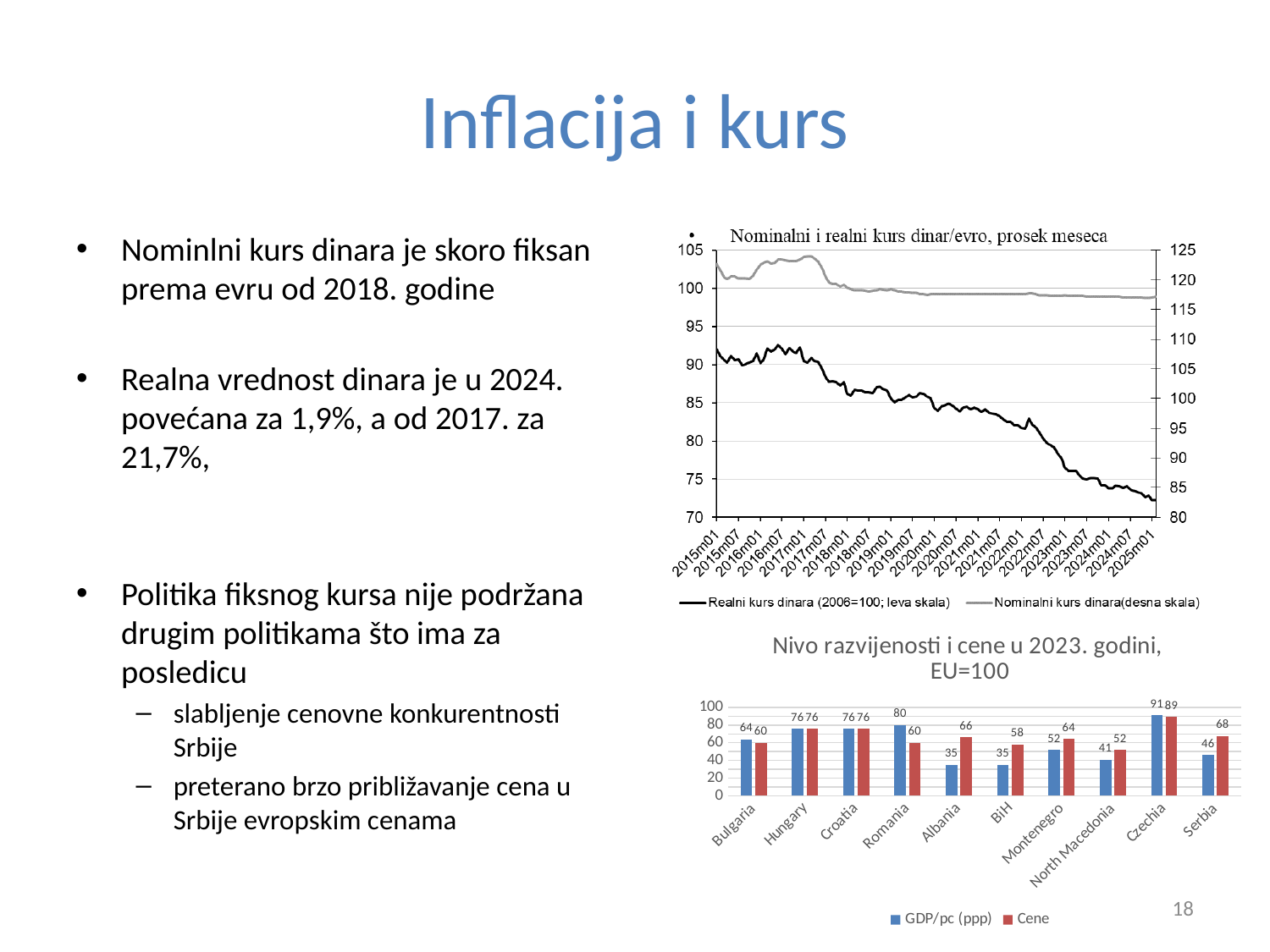
In the chart titled 'Nivo razvijenosti i cene u 2023. godini, EU=100', how many countries are shown? 10 In the chart titled 'Nivo razvijenosti i cene u 2023. godini, EU=100', what is the GDP/pc (ppp) value for Serbia? 46 In the chart titled 'Nivo razvijenosti i cene u 2023. godini, EU=100', what is the Cene value for Albania? 66 In the chart titled 'Nivo razvijenosti i cene u 2023. godini, EU=100', is the GDP/pc (ppp) value for Romania larger or the Cene value for Romania? GDP/pc (ppp) In the chart titled 'Nominalni i realni kurs dinar/evro, prosek meseca', does the real exchange rate of the dinar (Realni kurs dinara) rise or fall from 2015m01 to 2025m01? Fall In the chart titled 'Nivo razvijenosti i cene u 2023. godini, EU=100', how many series does the legend list? 2 In the chart titled 'Nivo razvijenosti i cene u 2023. godini, EU=100', which country has the highest GDP/pc (ppp) value? Czechia What kind of chart is the chart titled 'Nivo razvijenosti i cene u 2023. godini, EU=100'? Bar chart In the chart titled 'Nivo razvijenosti i cene u 2023. godini, EU=100', what is the difference between the Cene value and the GDP/pc (ppp) value for Serbia? 22 In the chart titled 'Nivo razvijenosti i cene u 2023. godini, EU=100', which country has the lowest Cene value? North Macedonia What kind of chart is the chart titled 'Nominalni i realni kurs dinar/evro, prosek meseca'? Line chart In the chart titled 'Nominalni i realni kurs dinar/evro, prosek meseca', is the value of Realni kurs dinara at 2025m01 greater or less than 75? less